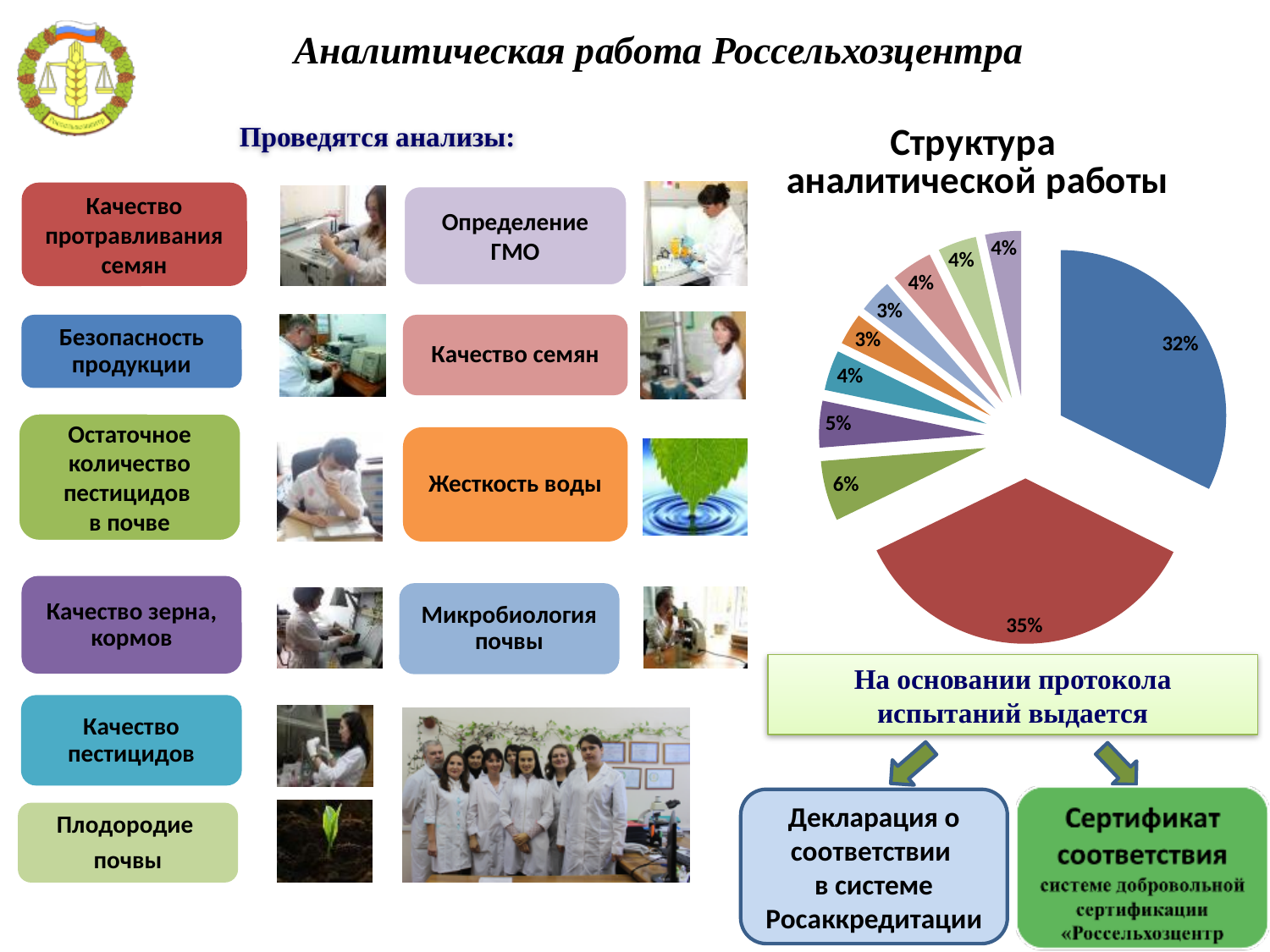
In the pie chart "Структура аналитической работы", what is the value of the blue slice? 32% In the pie chart "Структура аналитической работы", what is the difference between the two largest slices (35% and 32%)? 3% What is the value of the largest slice in the pie chart "Структура аналитической работы"? 35% In the pie chart "Структура аналитической работы", how many slices are labelled 4%? 4 In the pie chart "Структура аналитической работы", which is larger: the blue slice or the red slice? the red slice Does the pie chart "Структура аналитической работы" show a legend with category names? No What kind of chart is shown under the title "Структура аналитической работы"? pie chart In the pie chart "Структура аналитической работы", what is the value of the green slice next to the red one? 6% What is the value of the smallest slice in the pie chart "Структура аналитической работы"? 3% How many slices does the pie chart "Структура аналитической работы" have? 10 In the pie chart "Структура аналитической работы", what is the combined share of the two largest slices (35% and 32%)? 67% What is the title of the pie chart on the right side of the slide? Структура аналитической работы